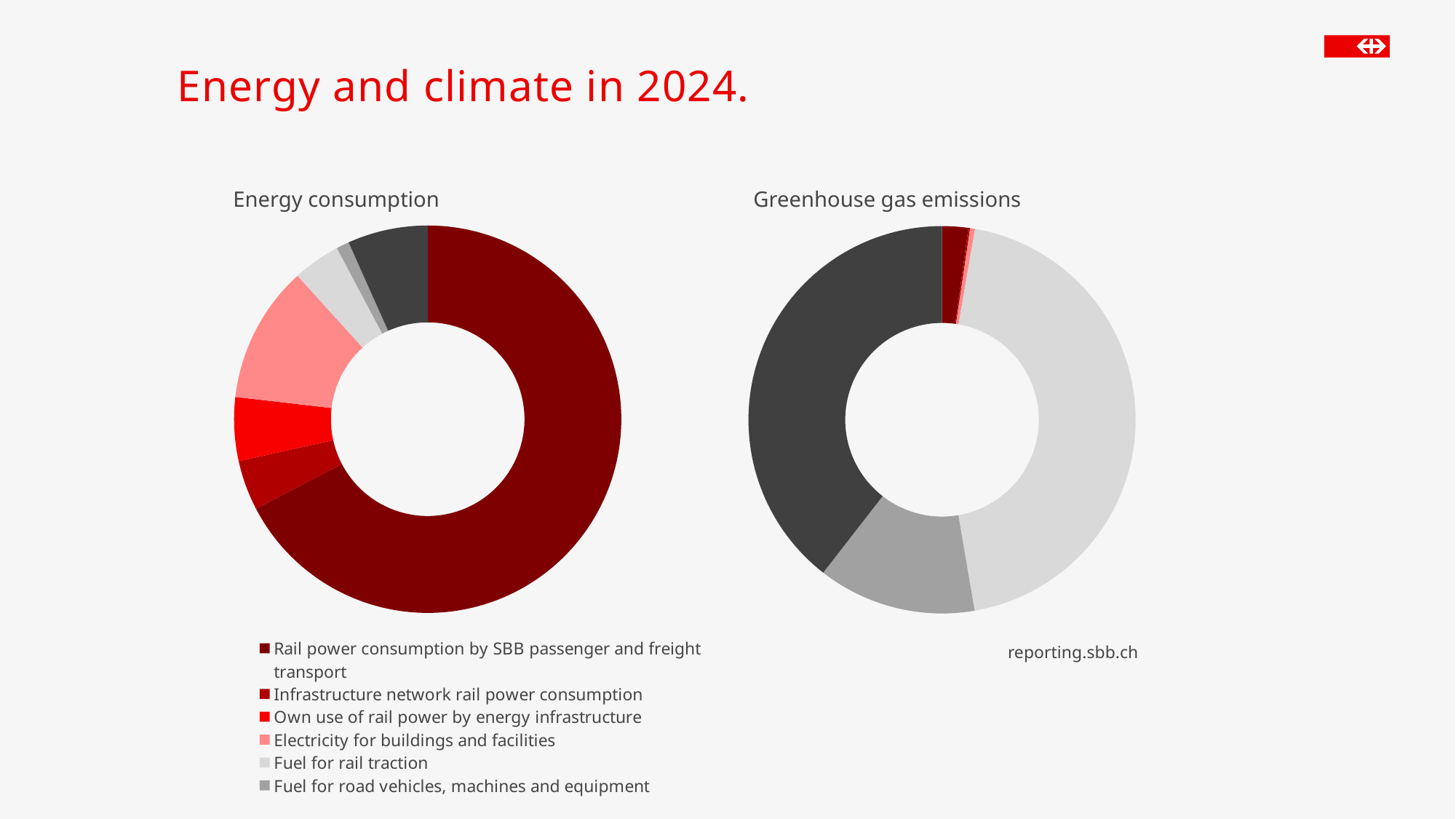
How many entries does the legend below the Energy consumption chart list? 6 In the Energy consumption chart, which is larger: Fuel for rail traction or Fuel for road vehicles, machines and equipment? Fuel for rail traction What kind of chart is the Greenhouse gas emissions chart? Doughnut chart In the Energy consumption chart, which is larger: Electricity for buildings and facilities or Own use of rail power by energy infrastructure? Electricity for buildings and facilities In the Energy consumption chart, which category has the smallest share? Fuel for road vehicles, machines and equipment What is the title of the slide? Energy and climate in 2024. In the Energy consumption chart, which category has the largest share? Rail power consumption by SBB passenger and freight transport What source is cited below the Greenhouse gas emissions chart? reporting.sbb.ch What kind of chart is the Energy consumption chart? Doughnut chart